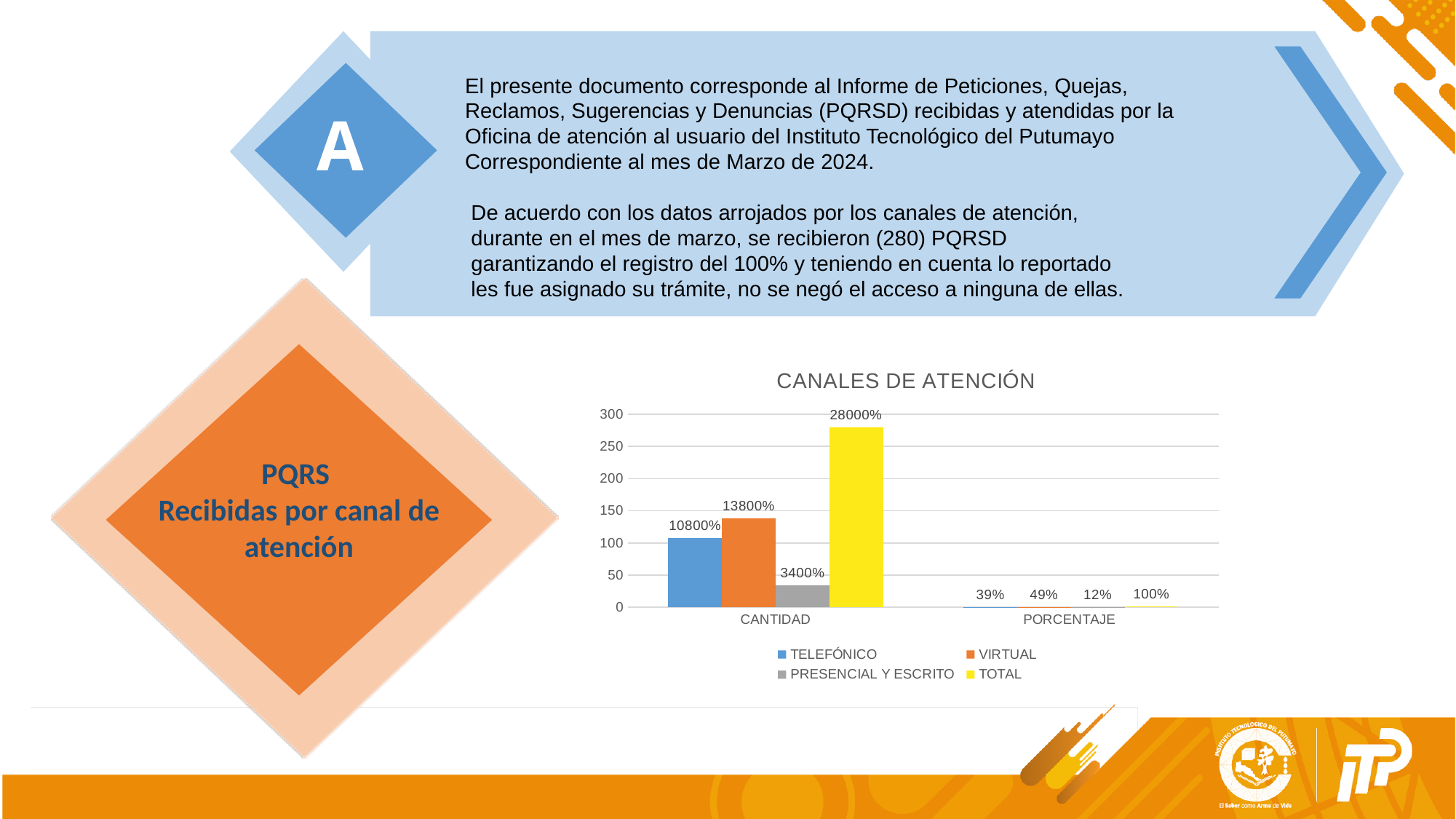
How many series does the chart legend list? 4 What is the data label for TOTAL in the PORCENTAJE category? 100% Which colour represents the TOTAL series in the chart? yellow How many categories are shown on the x axis of the chart? 2 What is the data label for TELEFÓNICO in the CANTIDAD category? 10800% What is the data label for VIRTUAL in the PORCENTAJE category? 49% What is the data label for PRESENCIAL Y ESCRITO in the CANTIDAD category? 3400% In the CANTIDAD category, which is larger: TELEFÓNICO or VIRTUAL? VIRTUAL What kind of chart is shown on the slide? bar chart What is the title of the chart on the slide? CANALES DE ATENCIÓN Which series has the lowest value in the CANTIDAD category? PRESENCIAL Y ESCRITO What is the data label for VIRTUAL in the CANTIDAD category? 13800%